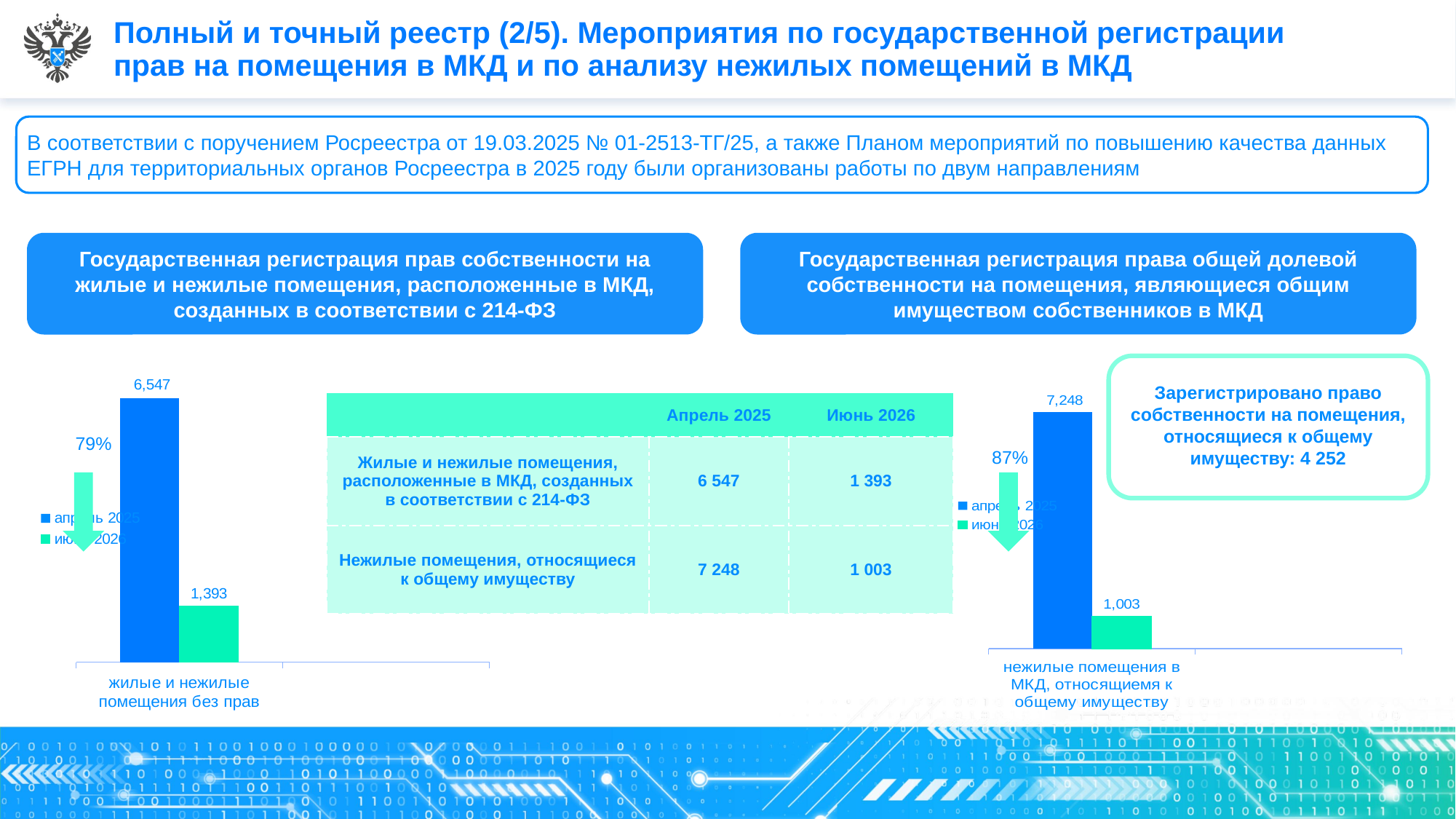
In the right chart, what is the value for апрель 2025? 7,248 What type of chart is the left chart? bar chart What is the category label on the x axis of the right chart? нежилые помещения в МКД, относящиемя к общему имуществу In the right chart, which series has the lower value? июнь 2026 In the right chart, what is the difference between the апрель 2025 and июнь 2026 values? 6,245 In the left chart, what is the difference between the апрель 2025 and июнь 2026 values? 5,154 How many series does the legend of the right chart list? 2 In the right chart, what is the value for июнь 2026? 1,003 In the left chart, what is the value for апрель 2025? 6,547 In the left chart, do the values rise or fall from апрель 2025 to июнь 2026? fall In the left chart, which series has the higher value, апрель 2025 or июнь 2026? апрель 2025 In the left chart, what is the value for июнь 2026? 1,393